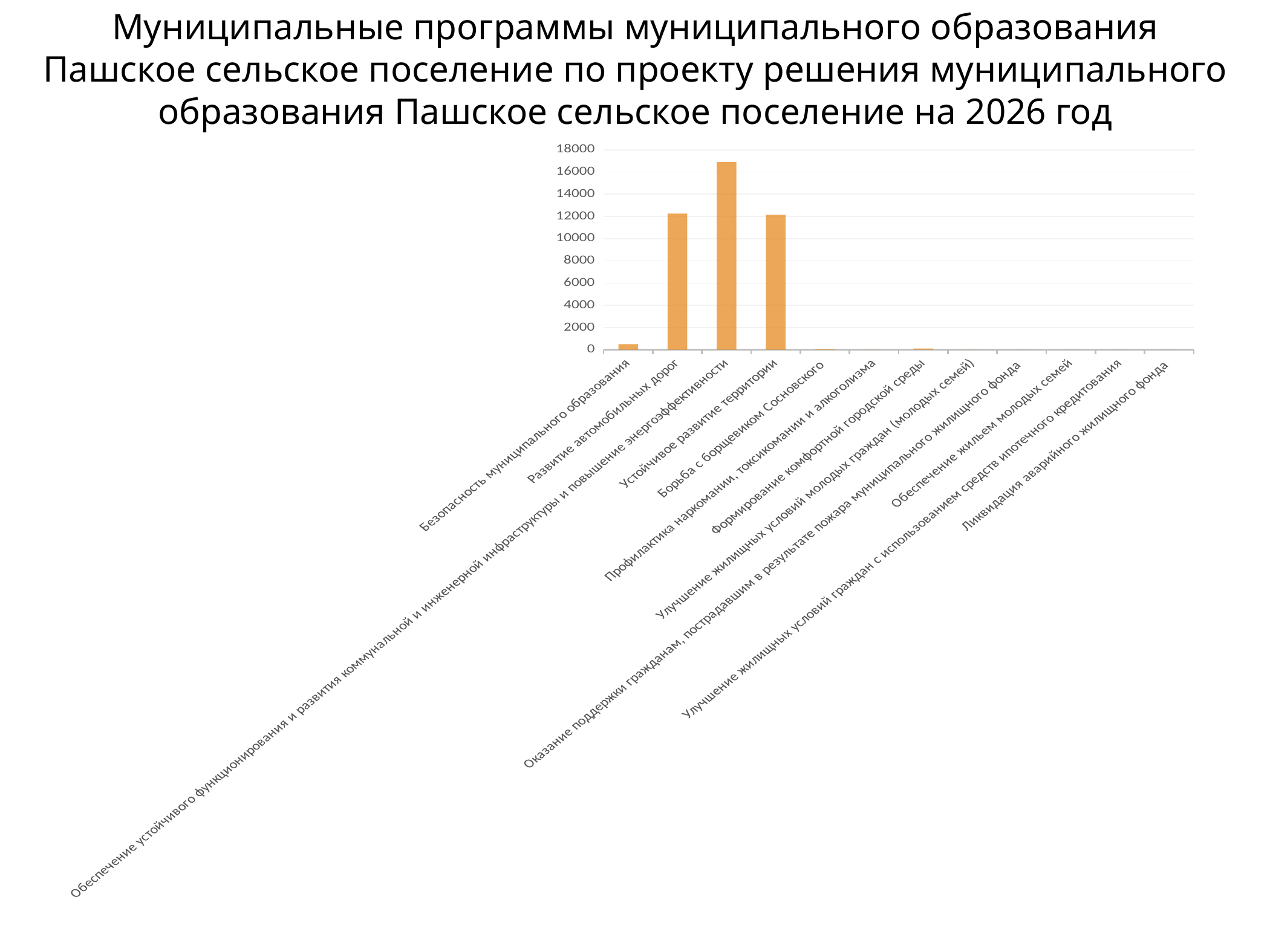
What colour are the bars in the chart? orange Is the value for Устойчивое развитие территории greater or less than 10000? greater Is the value for Развитие автомобильных дорог greater or less than 10000? greater How many categories are plotted on the x axis of the chart? 12 What kind of chart is shown on the slide? bar chart What is the highest value shown on the y axis of the chart? 18000 Is the value for Безопасность муниципального образования greater or less than 2000? less Which is larger, the value for Безопасность муниципального образования or the value for Развитие автомобильных дорог? Развитие автомобильных дорог Which category has the highest bar in the chart? Обеспечение устойчивого функционирования и развития коммунальной и инженерной инфраструктуры и повышение энергоэффективности Which is larger, the value for Устойчивое развитие территории or the value for Обеспечение устойчивого функционирования и развития коммунальной и инженерной инфраструктуры и повышение энергоэффективности? Обеспечение устойчивого функционирования и развития коммунальной и инженерной инфраструктуры и повышение энергоэффективности